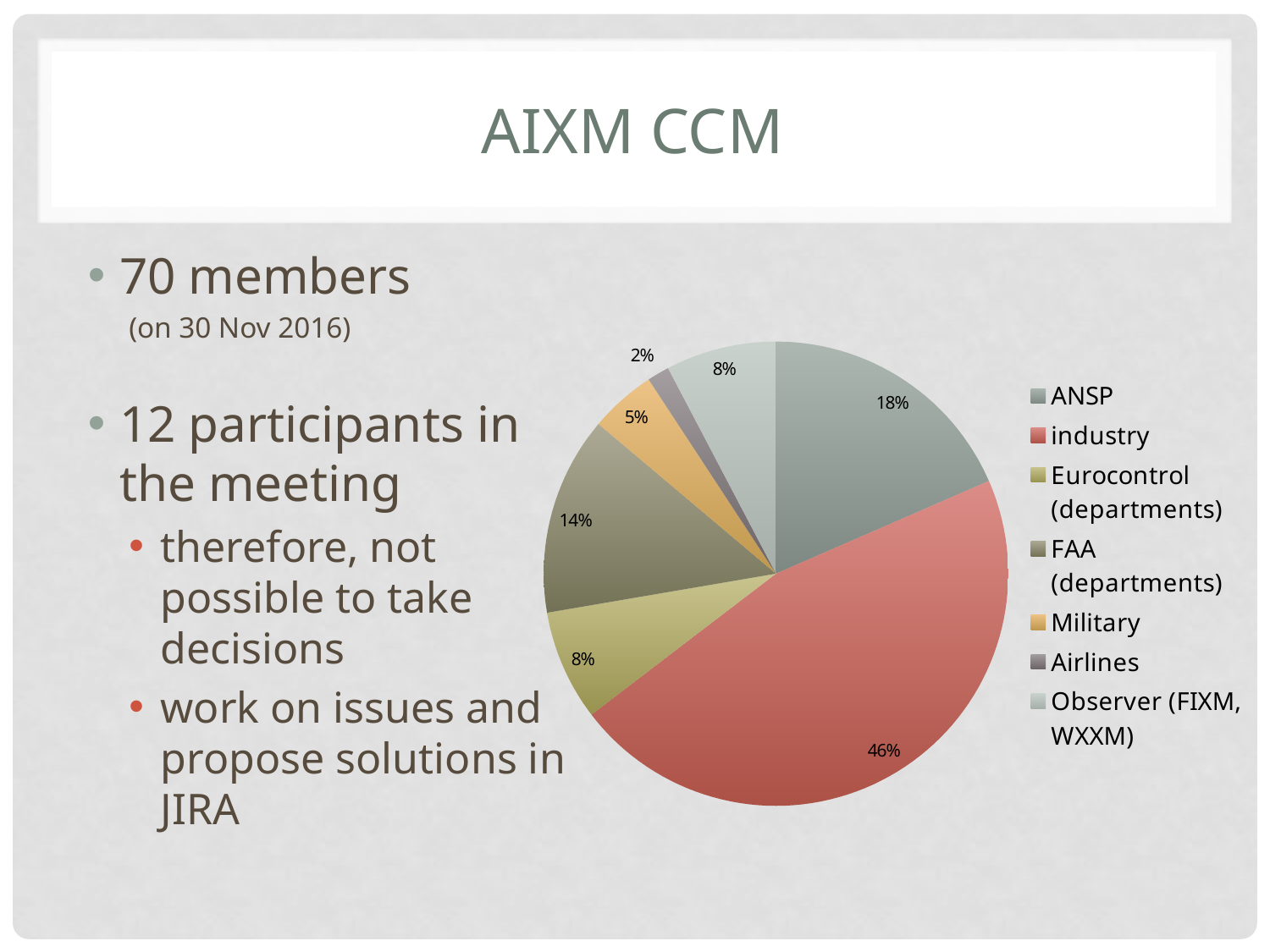
What kind of chart is shown on the slide? pie chart Which category has the largest slice of the pie? industry What share of the pie does FAA (departments) hold? 14% What share of the pie does industry hold? 46% What is the difference in percentage points between the industry slice and the ANSP slice? 28 How many categories does the legend of the pie chart list? 7 Which category has the smallest slice of the pie? Airlines What share of the pie does Military hold? 5% What is the title of the slide containing the pie chart? AIXM CCM Which slice is larger, FAA (departments) or Eurocontrol (departments)? FAA (departments)